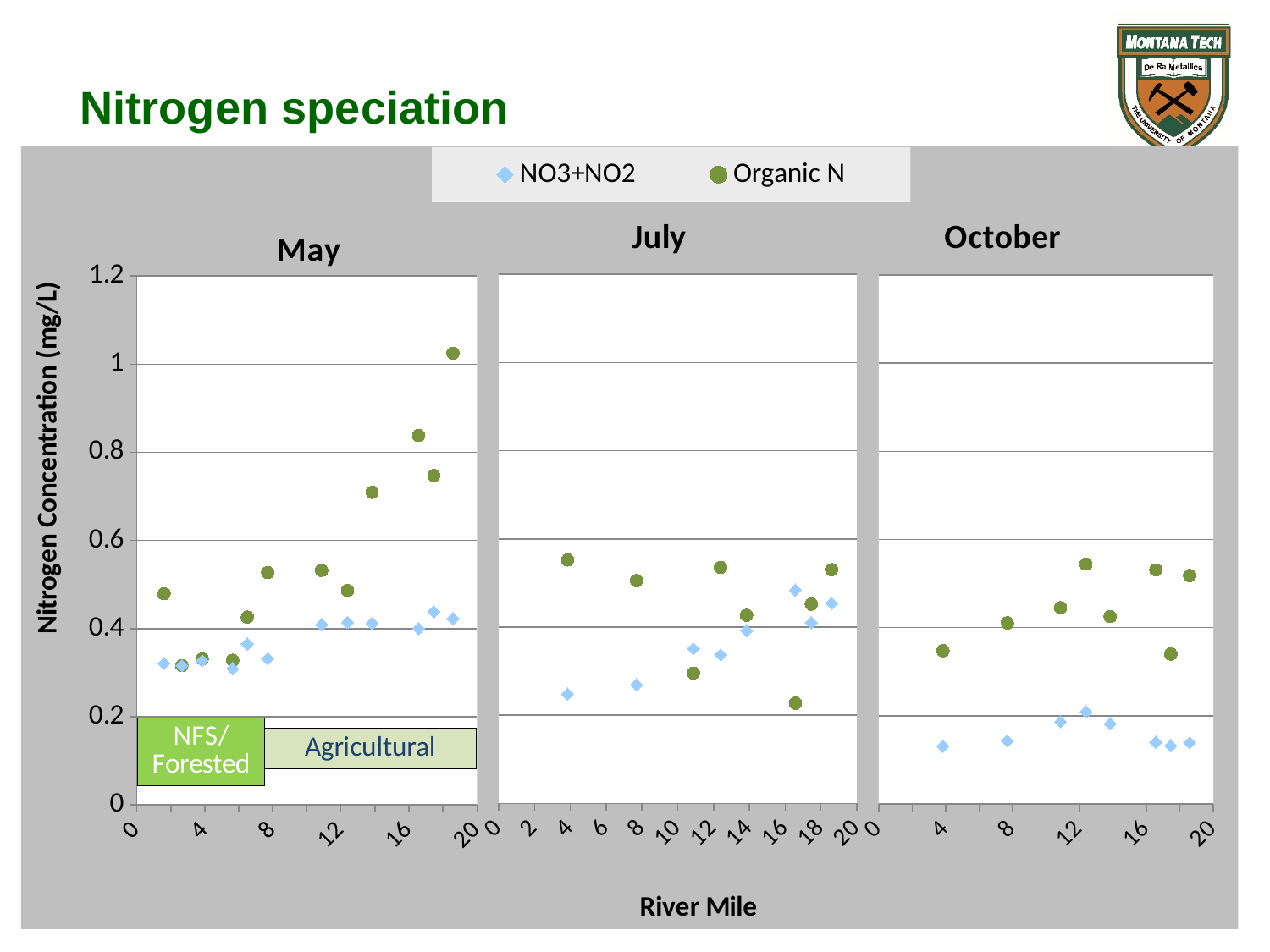
In the May chart, is the highest Organic N value greater or less than 0.8? greater In the May chart, do the Organic N values generally rise or fall as river mile increases? rise What are the two series named in the legend? NO3+NO2 and Organic N In the October chart, is the NO3+NO2 value at river mile 4 greater or less than 0.2? less In the July chart, is the lowest Organic N value greater or less than 0.4? less What kind of chart is used in the May, July and October panels? scatter chart How many series does the legend list? 2 How many month panels are shown on the slide? 3 In the October chart, which series has the higher values overall, NO3+NO2 or Organic N? Organic N What is the label of the shared x axis? River Mile Which month panel contains the highest Organic N value? May